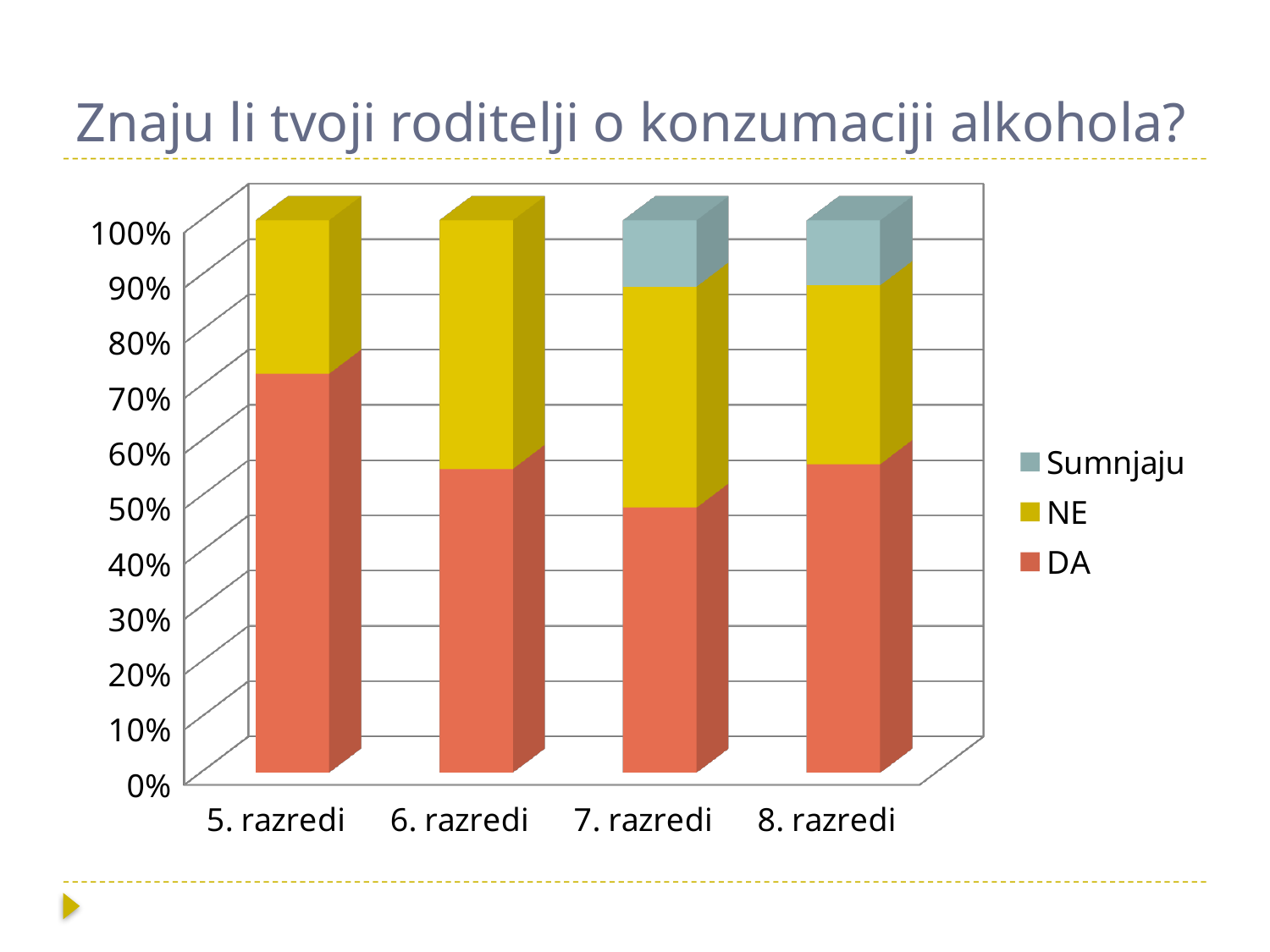
How many series does the legend list? 3 Which has a larger NE share, 5. razredi or 6. razredi? 6. razredi Which category has the highest share of DA? 5. razredi Which category has the lowest share of DA? 7. razredi What kind of chart is shown on the slide? bar chart How many categories (grades) are shown on the x axis? 4 Which categories have a Sumnjaju segment? 7. razredi and 8. razredi Which has a larger DA share, 5. razredi or 6. razredi? 5. razredi Is the DA share for 7. razredi greater or less than 60%? less Is the DA share for 5. razredi greater or less than 60%? greater Is the Sumnjaju share for 8. razredi greater or less than 20%? less What is the title of the chart? Znaju li tvoji roditelji o konzumaciji alkohola?